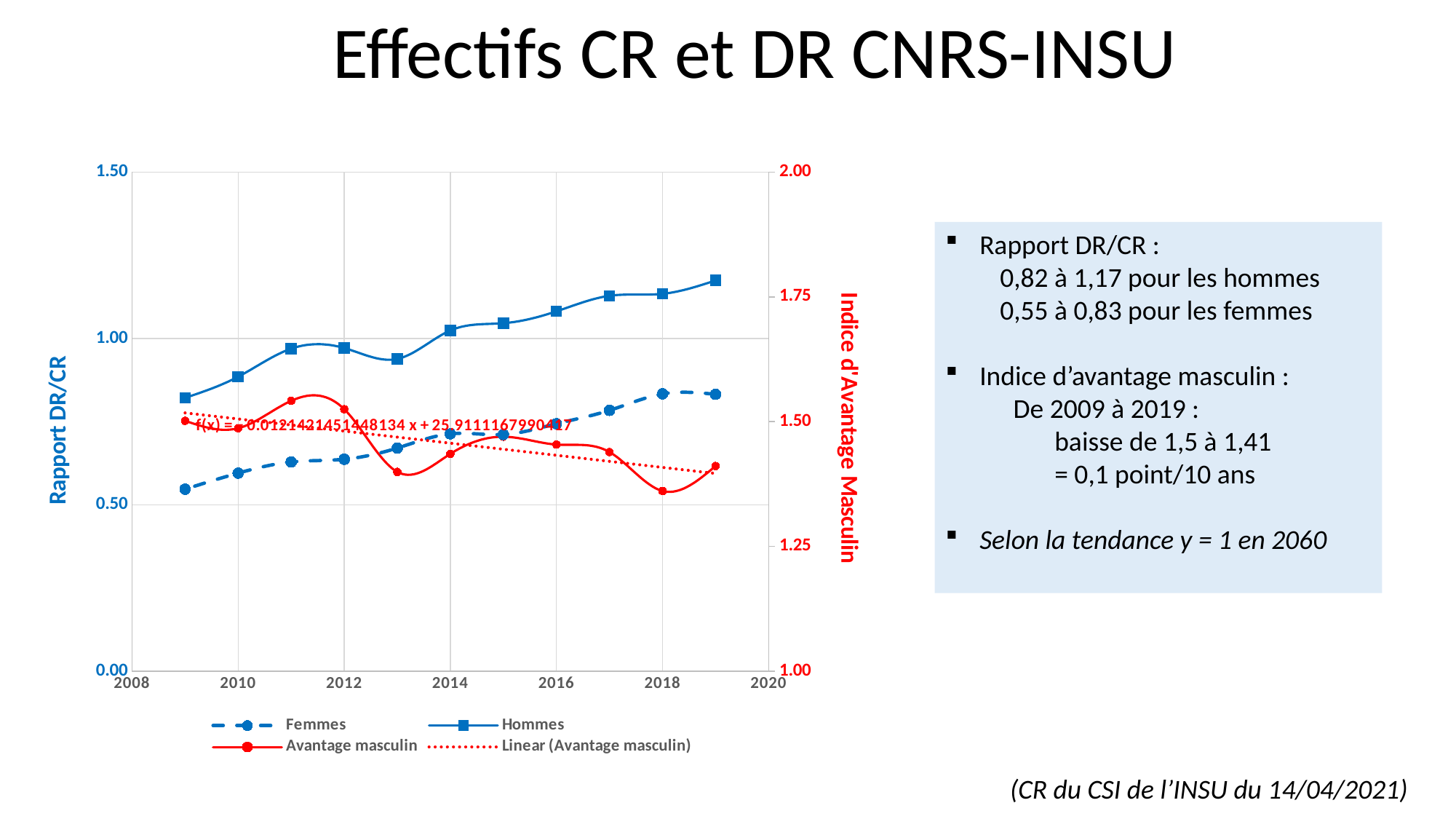
Does the Hommes series rise or fall from 2009 to 2019? rise What is the label of the left vertical axis? Rapport DR/CR In which year is the Femmes series at its lowest? 2009 Which series has the larger Rapport DR/CR in 2019, Hommes or Femmes? Hommes Is the value for Avantage masculin in 2018 greater or less than 1.50 on the Indice d'Avantage Masculin axis? less Does the Linear (Avantage masculin) trend line rise or fall from 2009 to 2019? fall Is the value for Avantage masculin in 2011 greater or less than 1.50 on the Indice d'Avantage Masculin axis? greater How many series does the chart legend list? 4 Is the value for Hommes in 2009 greater or less than 1.00 on the Rapport DR/CR axis? less What kind of chart is shown on the slide? line chart How many data points does the Hommes series have? 11